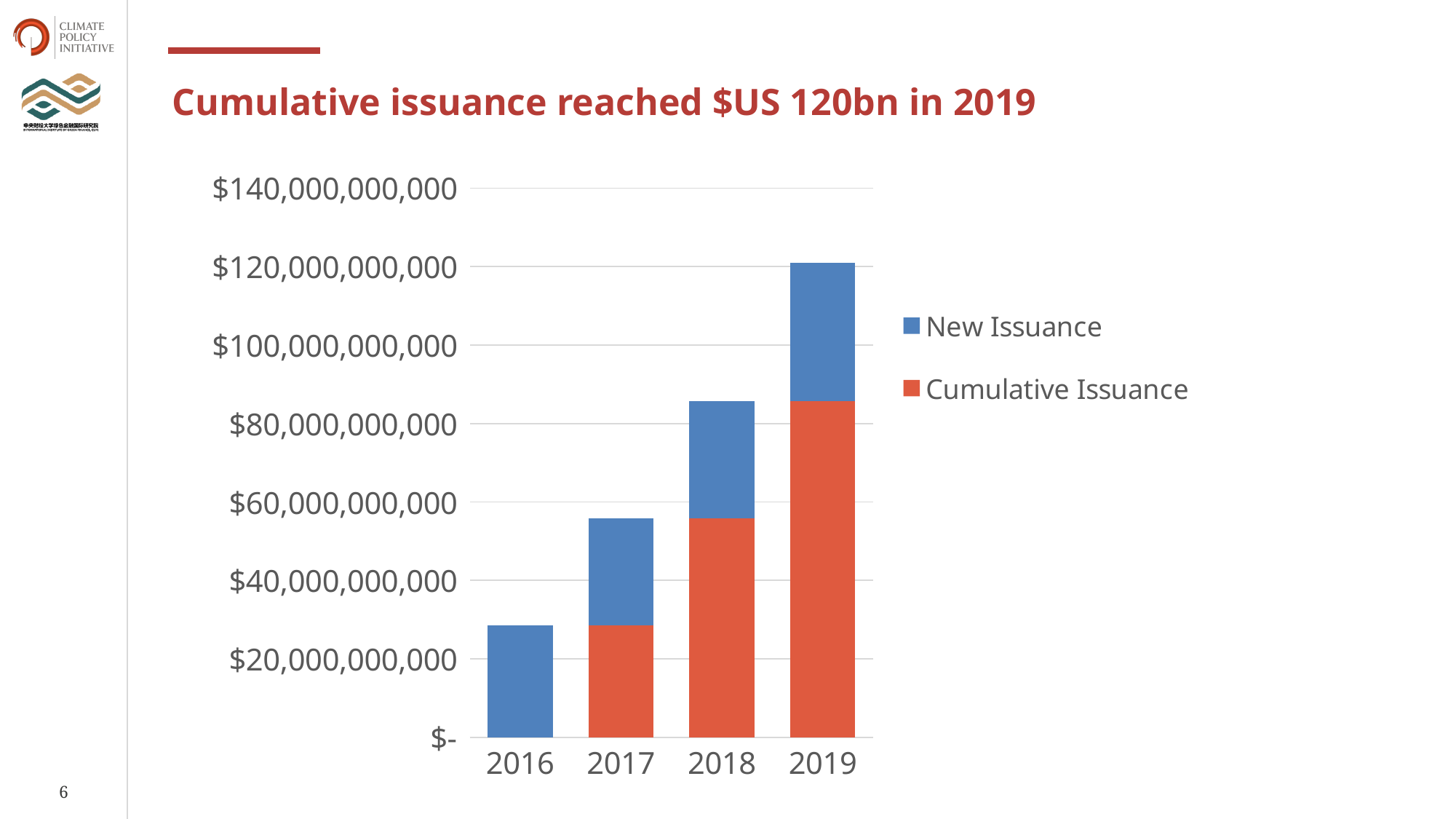
Do the total bar heights rise or fall from 2016 to 2019? Rise Which year has the shortest total bar in the chart? 2016 Which year has the tallest total bar in the chart? 2019 Is the total bar for 2019 greater or less than $100,000,000,000? greater Which colour represents Cumulative Issuance in the chart's legend? Red/orange What kind of chart is shown on the slide? Stacked bar chart Is the total bar for 2016 greater or less than $40,000,000,000? less Is the Cumulative Issuance segment for 2019 greater or less than $80,000,000,000? greater Which year has the larger total bar, 2017 or 2018? 2018 How many series does the chart's legend list? 2 How many years are shown on the x axis of the chart? 4